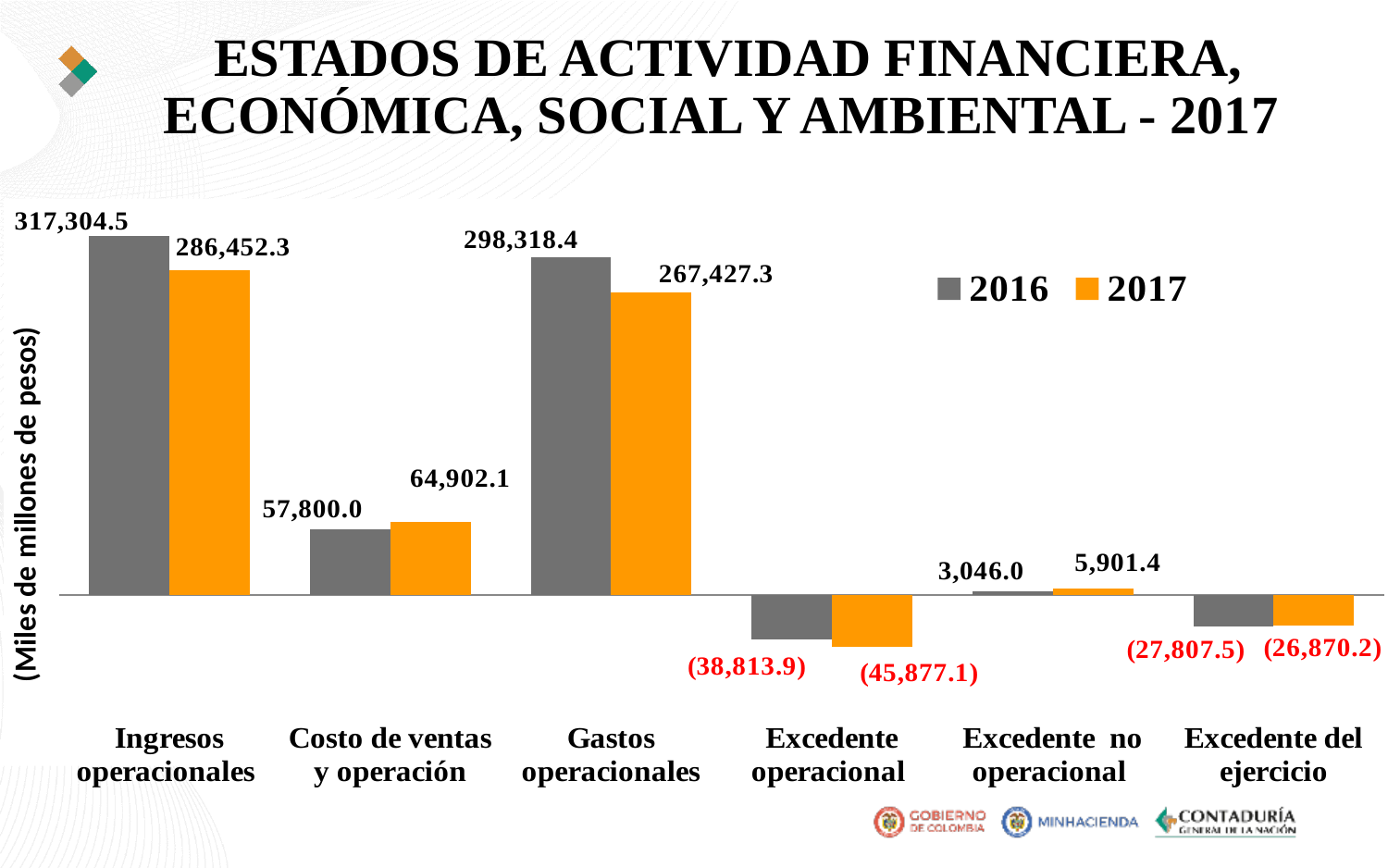
Which category has the lowest 2017 value? Excedente operacional What is the difference between the 2016 and 2017 values for Ingresos operacionales? 30,852.2 What kind of chart is shown on the slide? Bar chart What is the difference between the 2017 and 2016 values for Costo de ventas y operación? 7,102.1 Which is larger for Excedente no operacional, the 2016 value or the 2017 value? 2017 How many categories are shown on the x axis? 6 How many series does the legend list? 2 What is the 2016 value for Excedente del ejercicio? (27,807.5) What is the 2017 value for Gastos operacionales? 267,427.3 What is the 2017 value for Excedente operacional? (45,877.1) What is the 2016 value for Ingresos operacionales? 317,304.5 Which category has the highest 2016 value? Ingresos operacionales